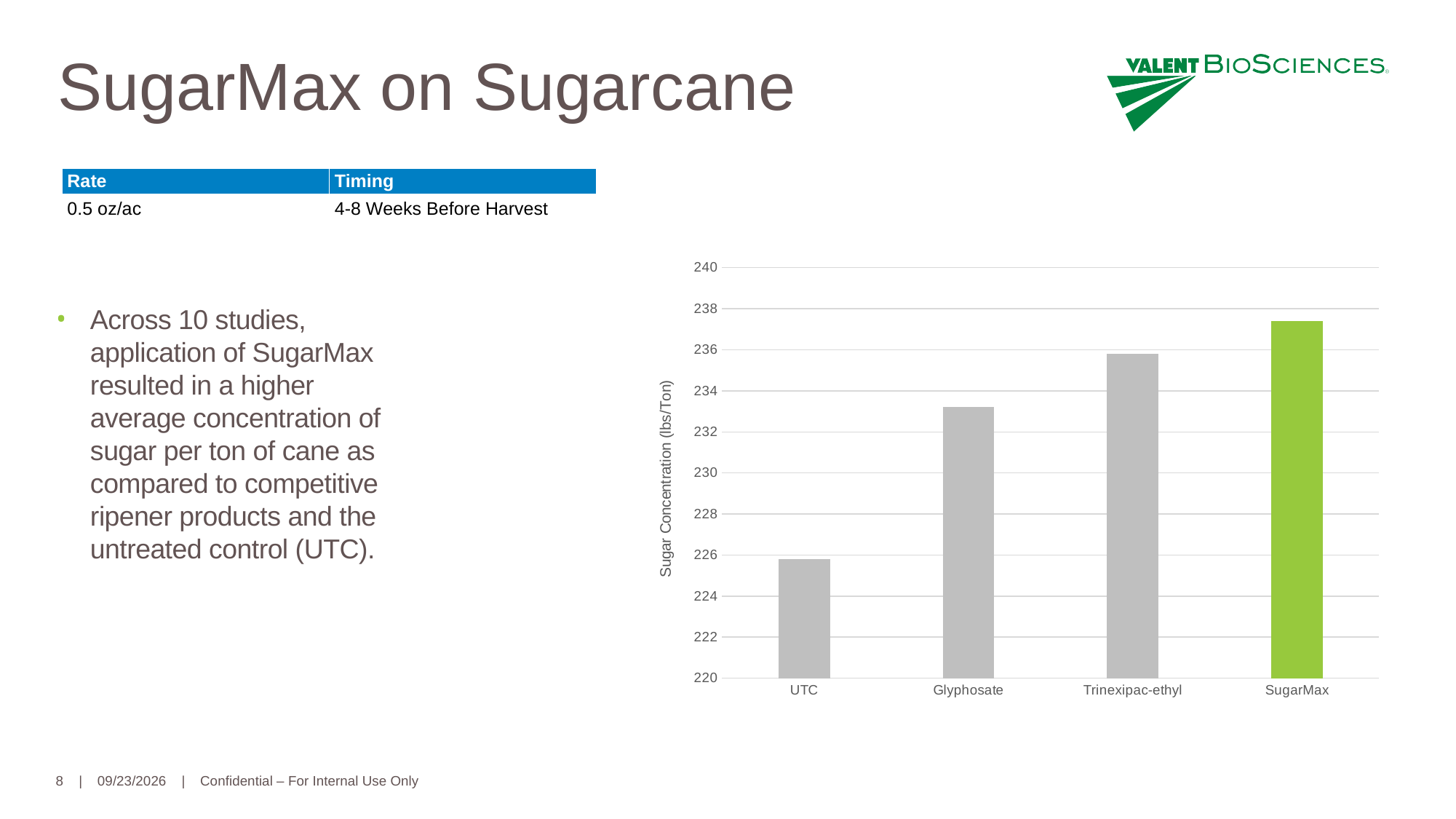
Is the value for UTC greater or less than 228? less Is the value for Trinexipac-ethyl greater or less than 234? greater Which has a higher sugar concentration, Glyphosate or Trinexipac-ethyl? Trinexipac-ethyl What is the label on the y axis of the chart? Sugar Concentration (lbs/Ton) Which category has the highest sugar concentration in the chart? SugarMax How many categories are plotted on the x axis of the chart? 4 Which category has the lowest sugar concentration in the chart? UTC Do the bar values rise or fall from left to right across the x axis? rise Is the value for SugarMax greater or less than 238? less What kind of chart is shown on the slide? bar chart